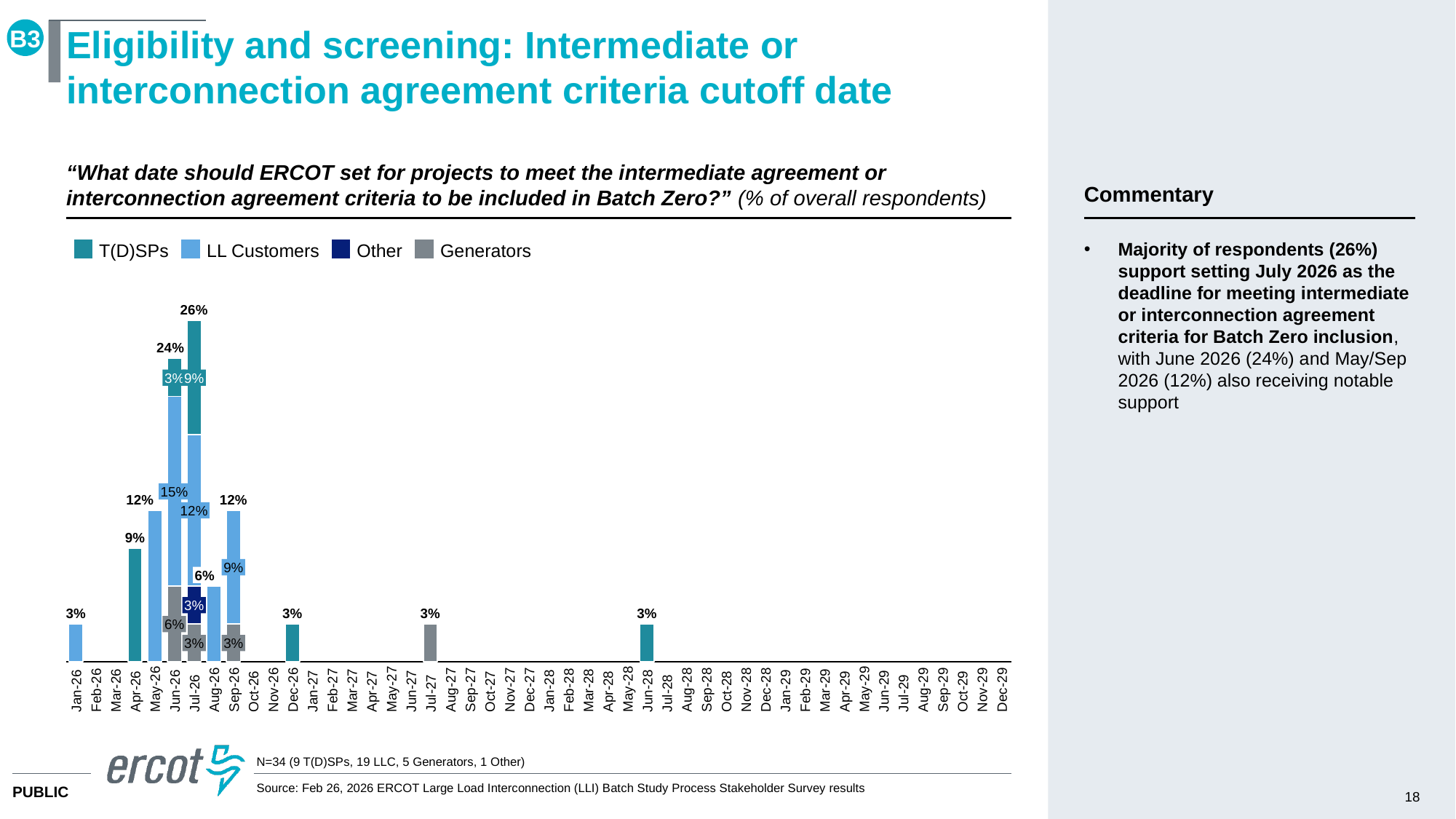
What is the overall percentage of respondents for Jun-26? 24% Which has a larger overall percentage, Apr-26 or May-26? May-26 Which month has the highest overall share of respondents? Jul-26 What percentage do LL Customers contribute to the Jun-26 bar? 15% What percentage do Generators contribute to the Jun-26 bar? 6% What percentage do T(D)SPs contribute to the Jul-26 bar? 9% What kind of chart is shown on the slide? Stacked bar chart How many series does the chart legend list? 4 What are the four series listed in the legend? T(D)SPs, LL Customers, Other, Generators What is the difference in overall percentage between Jul-26 and Jun-26? 2 percentage points What is the overall percentage of respondents for Apr-26? 9% What is the overall percentage of respondents for Jul-26? 26%